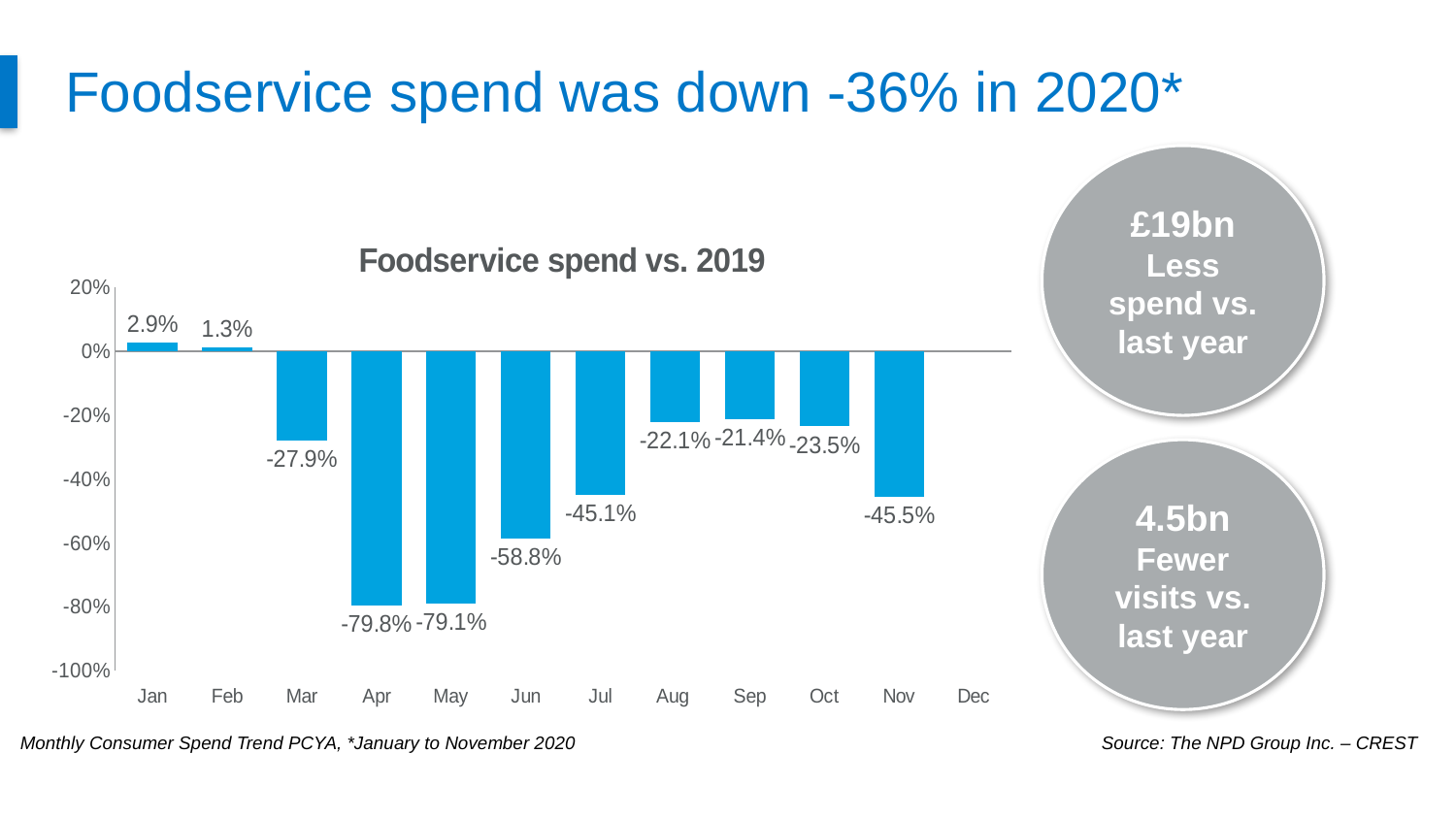
Which month has the lowest value in the Foodservice spend vs. 2019 chart? Apr In the Foodservice spend vs. 2019 chart, which is larger, the value for Jun or the value for Jul? Jul How many months have a bar plotted in the Foodservice spend vs. 2019 chart? 11 What is the value for Sep in the Foodservice spend vs. 2019 chart? -21.4% What is the value for Jun in the Foodservice spend vs. 2019 chart? -58.8% What is the value for Apr in the Foodservice spend vs. 2019 chart? -79.8% What is the difference between the Mar and Oct values in the Foodservice spend vs. 2019 chart? 4.4 percentage points What is the title of the chart on the slide? Foodservice spend vs. 2019 Do the values rise or fall from Apr to Sep in the Foodservice spend vs. 2019 chart? Rise What kind of chart is the Foodservice spend vs. 2019 chart? Bar chart Which month has the highest value in the Foodservice spend vs. 2019 chart? Jan What is the difference between the Jan and Feb values in the Foodservice spend vs. 2019 chart? 1.6 percentage points